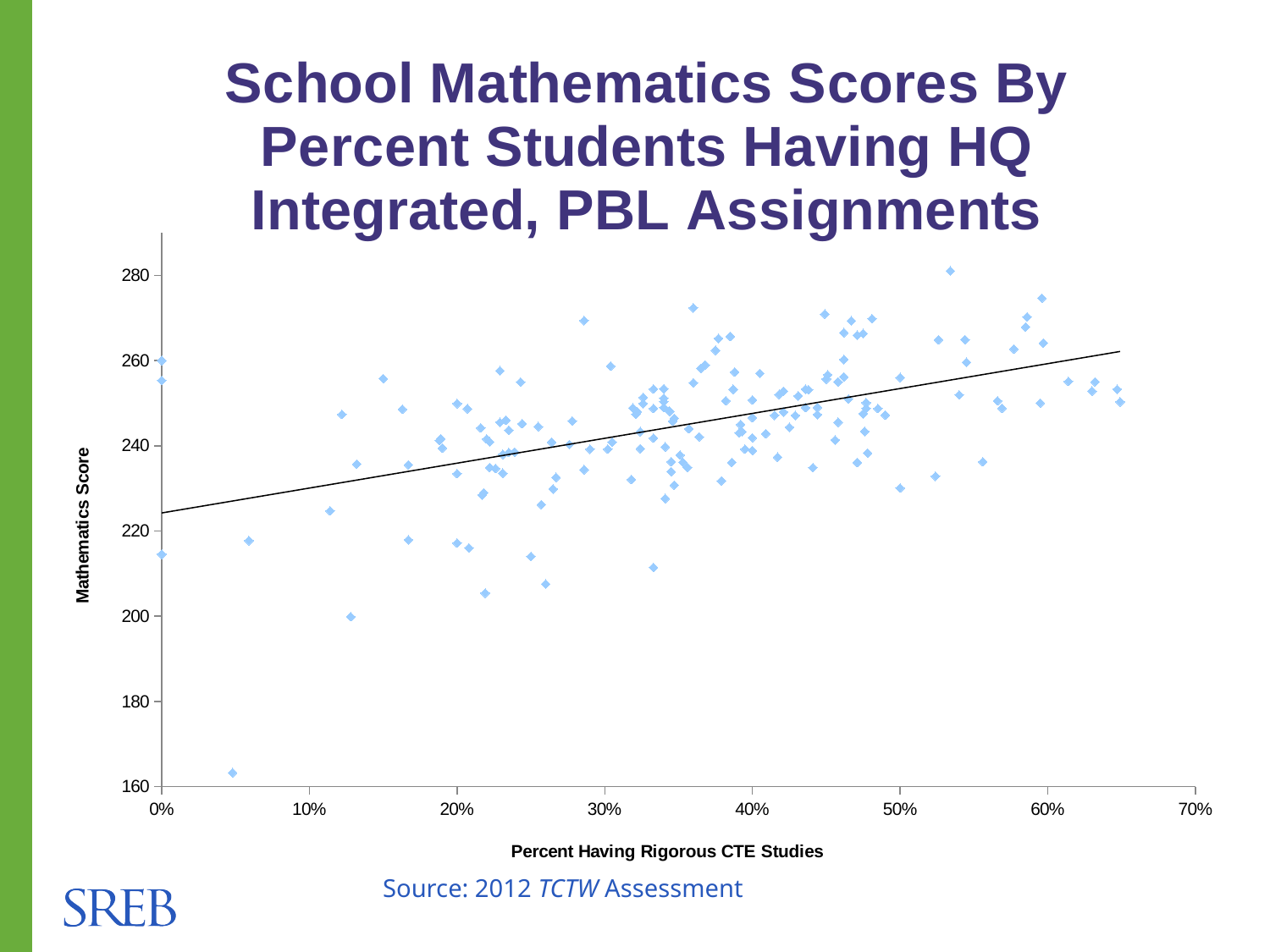
Is the lowest plotted mathematics score greater or less than 180? less Is the trend line's value at 60% greater or less than 240? greater What is the label of the vertical axis? Mathematics Score Is the trend line's value at 0% greater or less than 220? greater What kind of chart is shown on the slide? scatter plot What is the highest tick value shown on the horizontal axis? 70% What is the label of the horizontal axis? Percent Having Rigorous CTE Studies Does the trend line rise or fall as the percent having rigorous CTE studies increases? rises